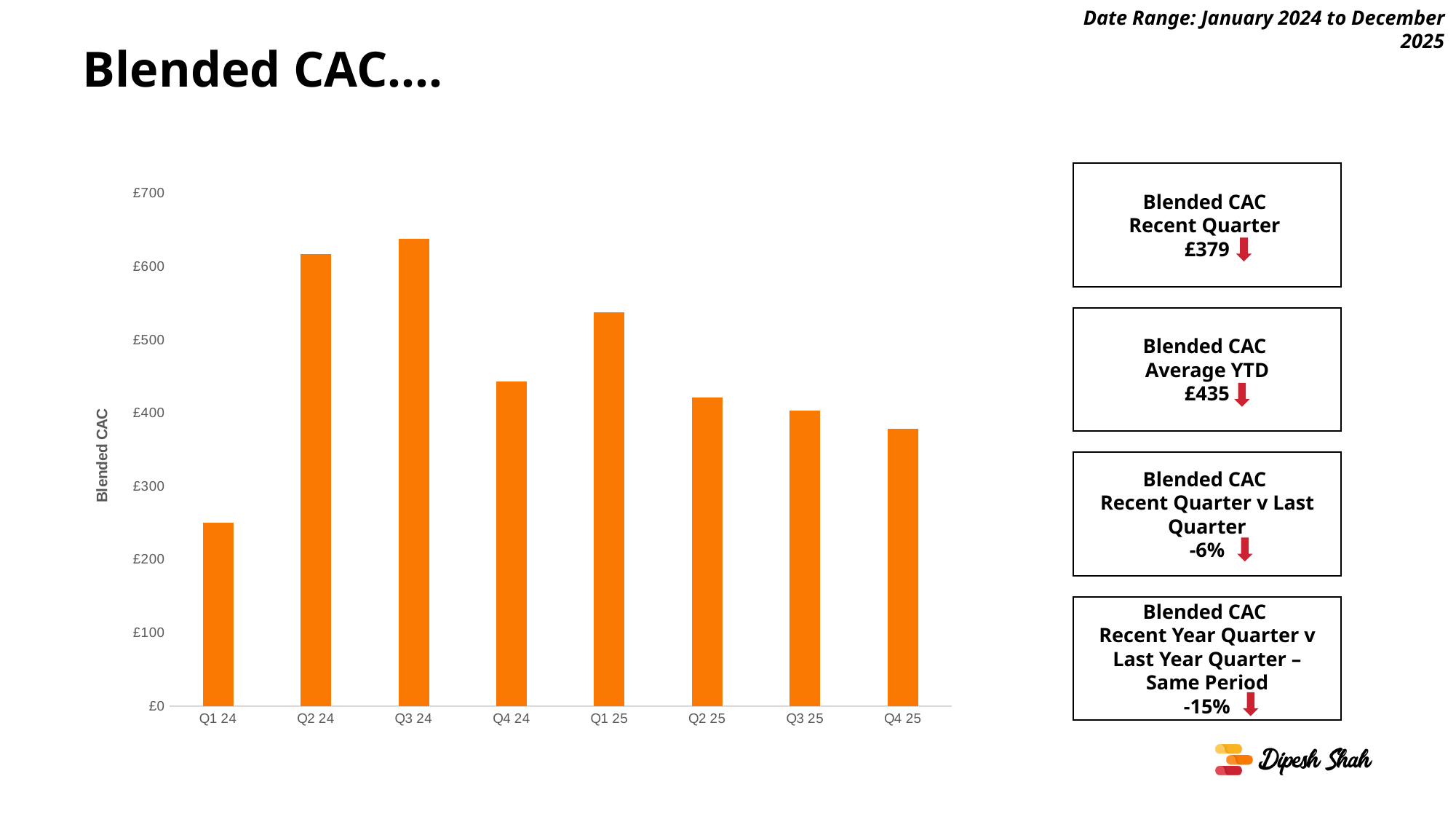
How many quarters are plotted on the chart? 8 Is the value for Q1 25 greater or less than £500? greater What is the title of the slide? Blended CAC.... Is the value for Q2 24 greater or less than £600? greater Is the value for Q1 24 greater or less than £300? less Which quarter has the lowest Blended CAC? Q1 24 What kind of chart is shown on the slide? Bar chart Which is larger, the value for Q4 24 or the value for Q1 25? Q1 25 Do the values rise or fall from Q1 25 to Q4 25? Fall What is the label on the vertical axis of the chart? Blended CAC Which quarter has the highest Blended CAC? Q3 24